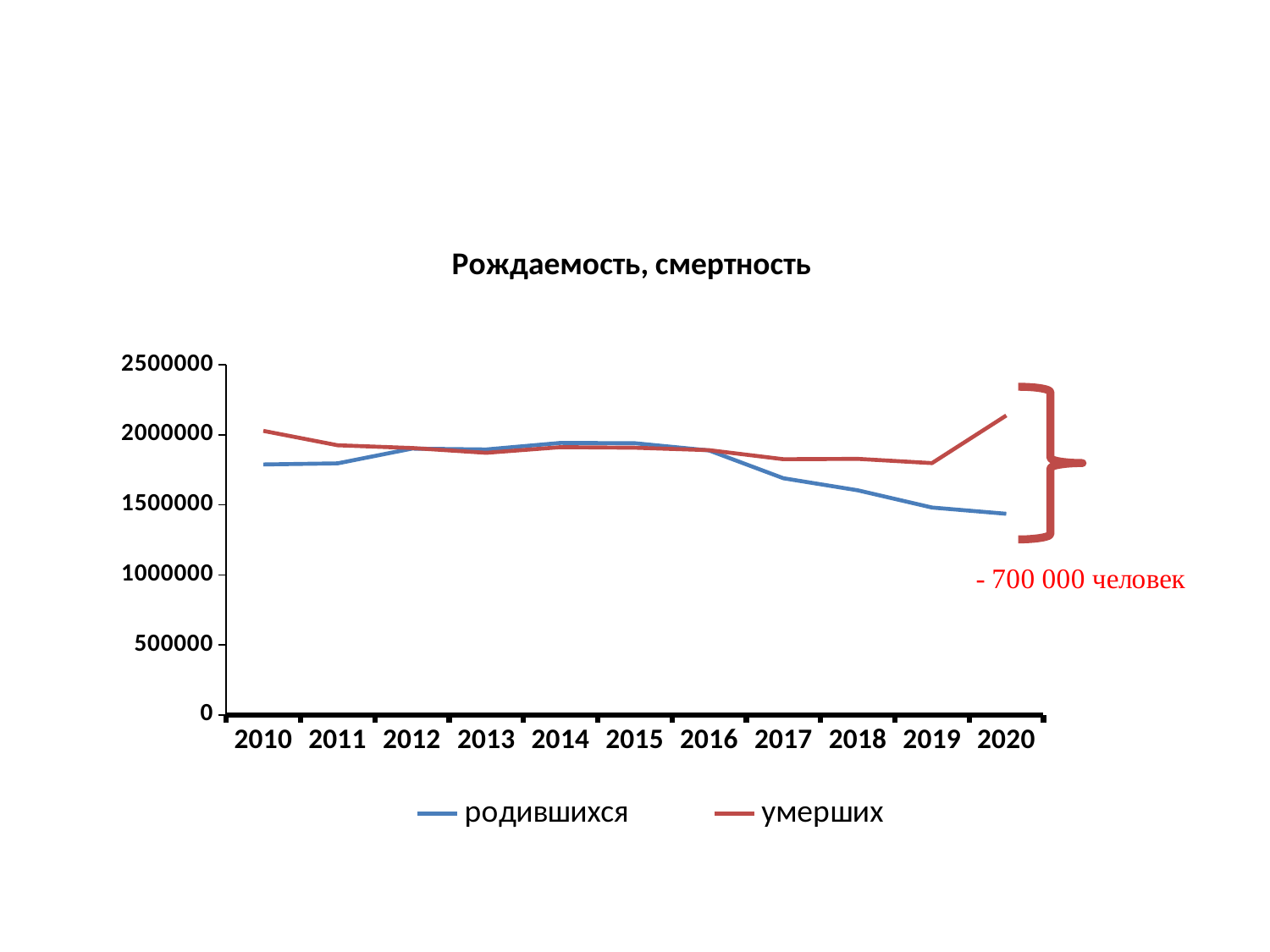
Is the value for умерших in 2020 greater or less than 2000000? greater Which series is drawn in red? умерших What is the title of the chart? Рождаемость, смертность How many series does the legend list? 2 Is the value for родившихся in 2020 greater or less than 1500000? less Is the value for умерших in 2019 greater or less than 2000000? less In which year is the value for родившихся lowest? 2020 In which year is the value for умерших highest? 2020 How many years are shown on the x axis? 11 In 2020, which series has the higher value, родившихся or умерших? умерших What kind of chart is shown on the slide? line chart